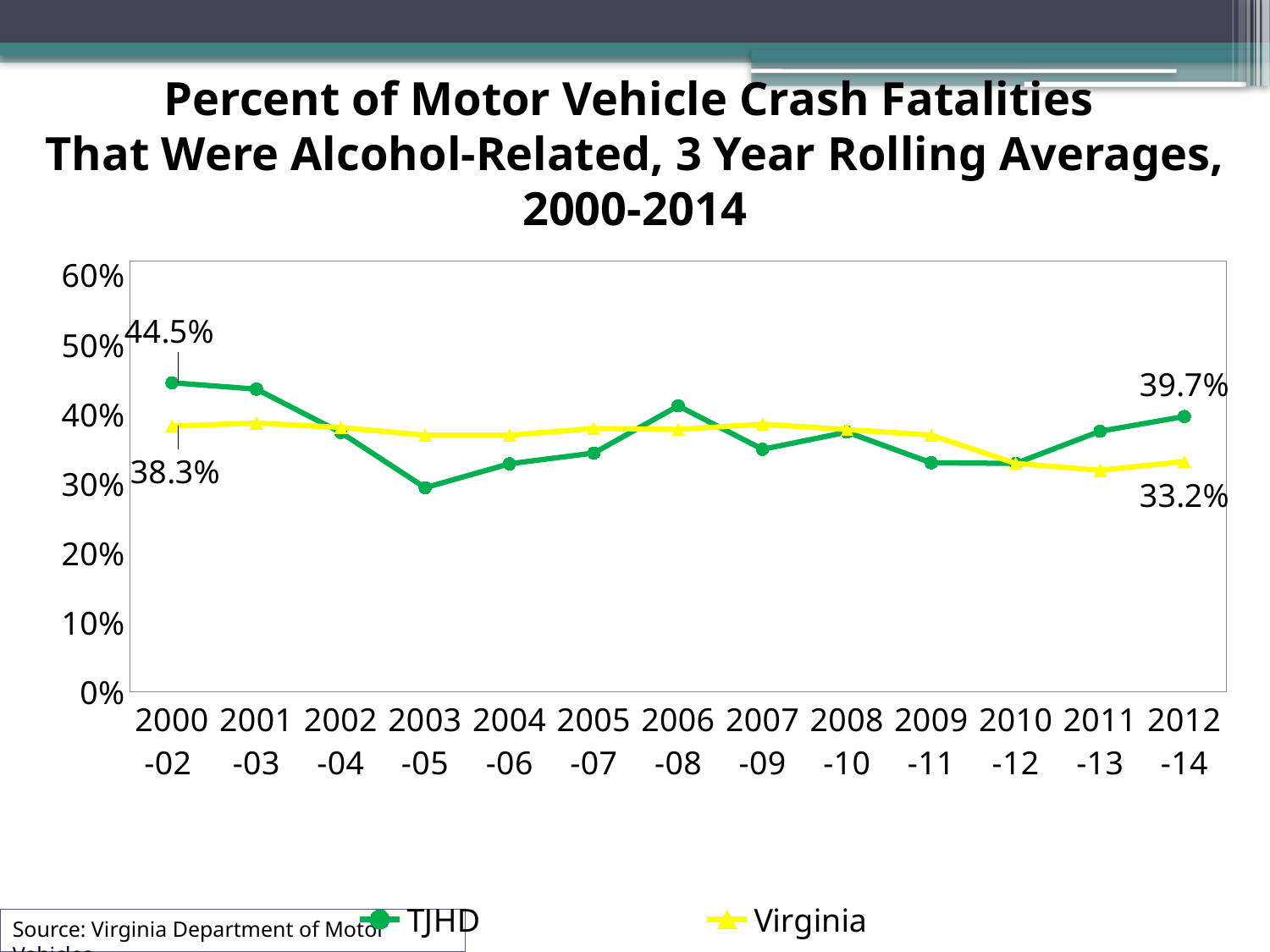
What is the TJHD value for 2000-02? 44.5% How many time periods are shown on the x axis? 13 What is the TJHD value for 2012-14? 39.7% What is the Virginia value for 2000-02? 38.3% What kind of chart is shown on the slide? line chart In 2000-02, which series has the higher value, TJHD or Virginia? TJHD In which period is the TJHD value lowest? 2003-05 What is the Virginia value for 2012-14? 33.2% Is the TJHD value for 2003-05 greater or less than 40%? less How many series does the legend list? 2 By how many percentage points did the TJHD value fall from 2000-02 to 2012-14? 4.8 percentage points What is the difference between the TJHD and Virginia values in 2012-14? 6.5 percentage points